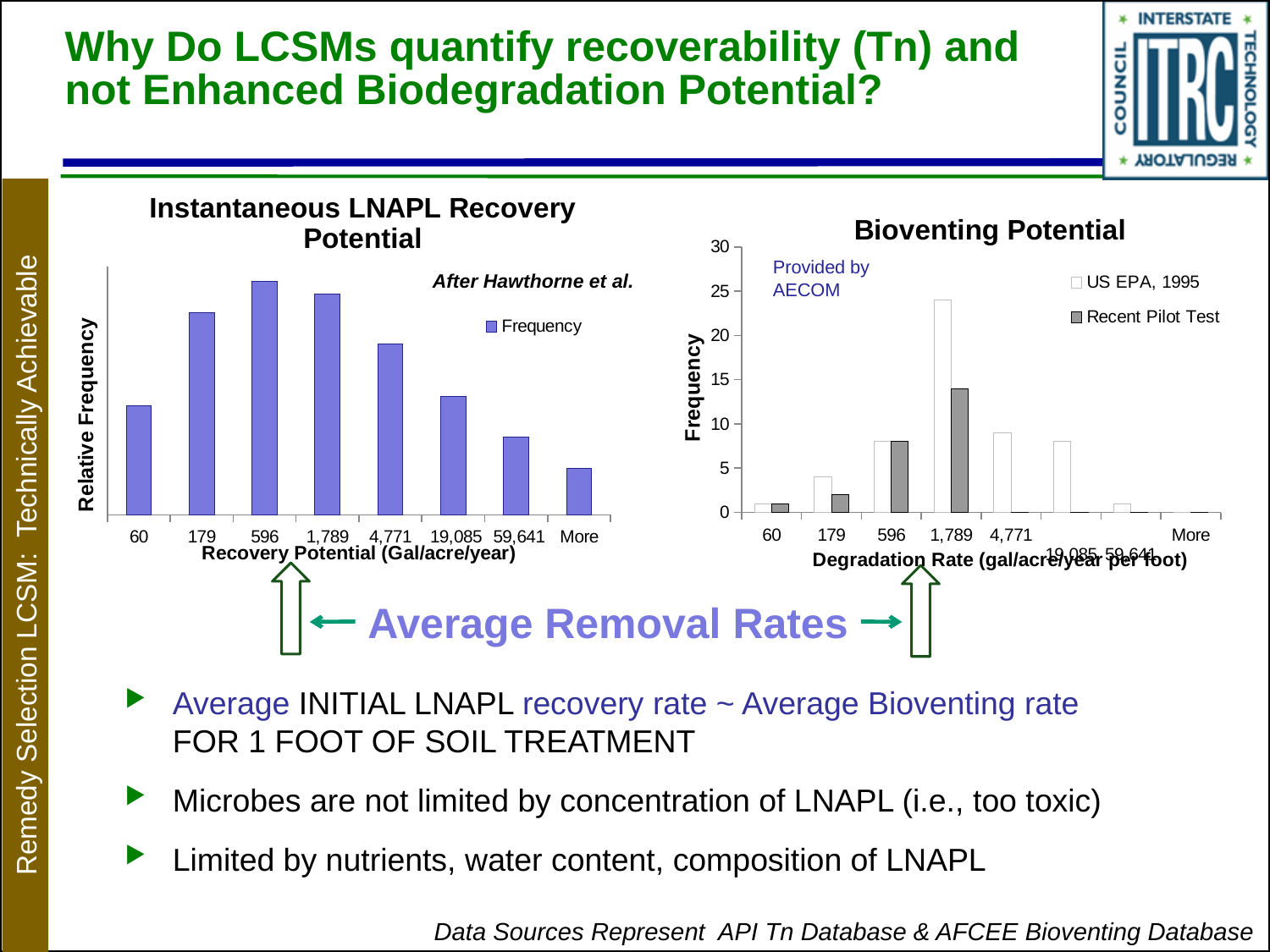
In the 'Bioventing Potential' chart, at category 1,789, which series has the larger value, US EPA, 1995 or Recent Pilot Test? US EPA, 1995 In the 'Bioventing Potential' chart, is the US EPA, 1995 value for 1,789 greater or less than 20? greater In the 'Instantaneous LNAPL Recovery Potential' chart, which category has the highest bar? 596 In the 'Instantaneous LNAPL Recovery Potential' chart, which category has the lowest bar? More In the 'Bioventing Potential' chart, is the Recent Pilot Test value for 1,789 greater or less than 10? greater How many series does the legend of the 'Bioventing Potential' chart list? 2 What kind of chart is the 'Instantaneous LNAPL Recovery Potential' chart? bar chart In the 'Bioventing Potential' chart, is the Recent Pilot Test value for 179 greater or less than 5? less In the 'Bioventing Potential' chart, which category has the highest US EPA, 1995 value? 1,789 What is the y-axis label of the 'Instantaneous LNAPL Recovery Potential' chart? Relative Frequency In the 'Instantaneous LNAPL Recovery Potential' chart, which is larger, the bar for 179 or the bar for 19,085? 179 How many categories are shown on the x axis of the 'Instantaneous LNAPL Recovery Potential' chart? 8